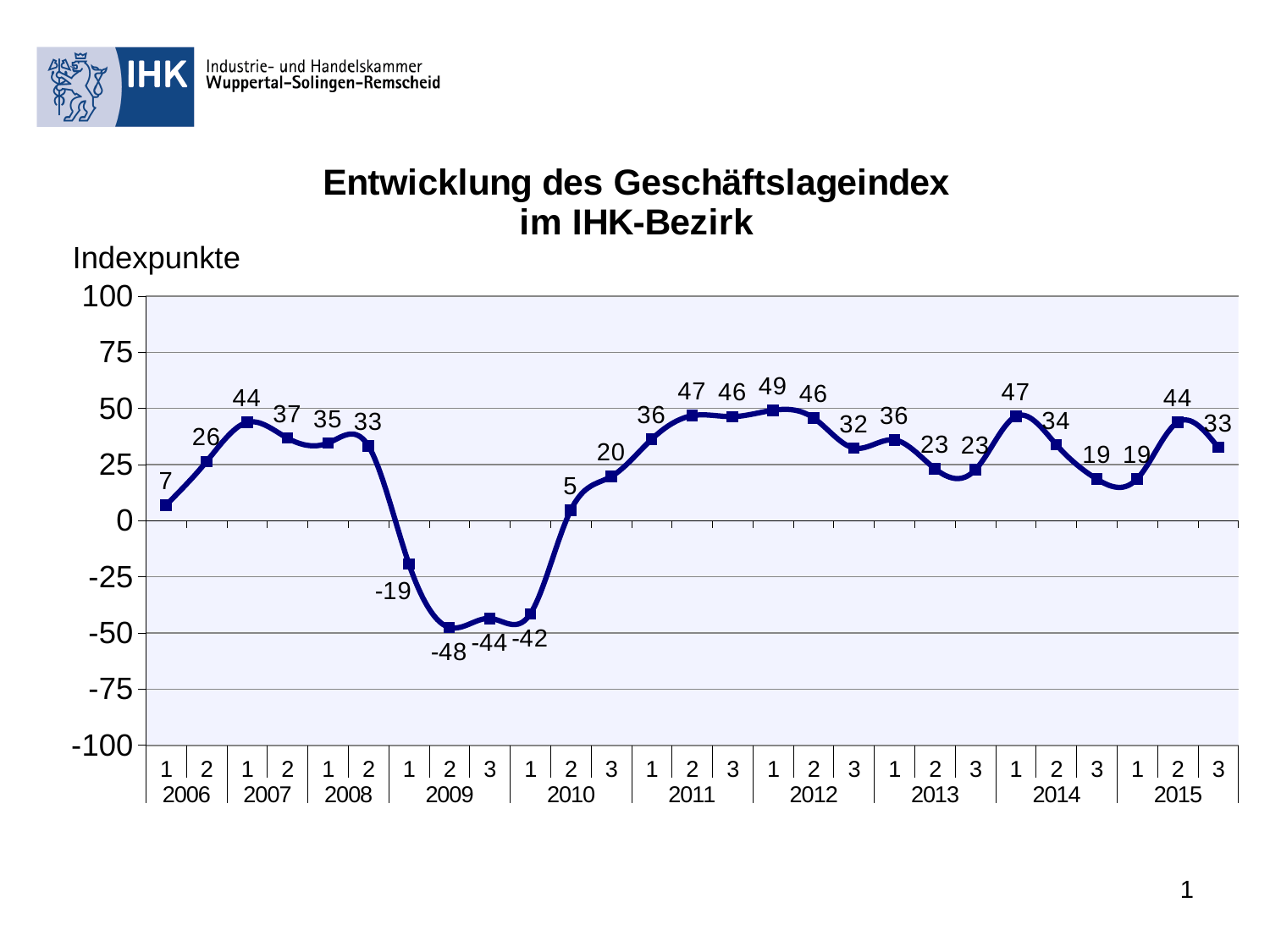
How many data points are plotted on the chart? 27 What type of chart is shown on the slide? line chart What is the difference between the index value in period 1 of 2007 and period 2 of 2007? 7 Which is larger, the index value for period 1 of 2014 or period 2 of 2014? 1 2014 What is the title of the chart? Entwicklung des Geschäftslageindex im IHK-Bezirk What is the label on the y axis of the chart? Indexpunkte Which period has the highest index value? 1 2012 What is the index value for period 1 of 2006? 7 Does the index value rise or fall from period 1 of 2009 to period 2 of 2009? fall Which period has the lowest index value? 2 2009 What is the index value for period 2 of 2009? -48 What is the index value for period 3 of 2015? 33